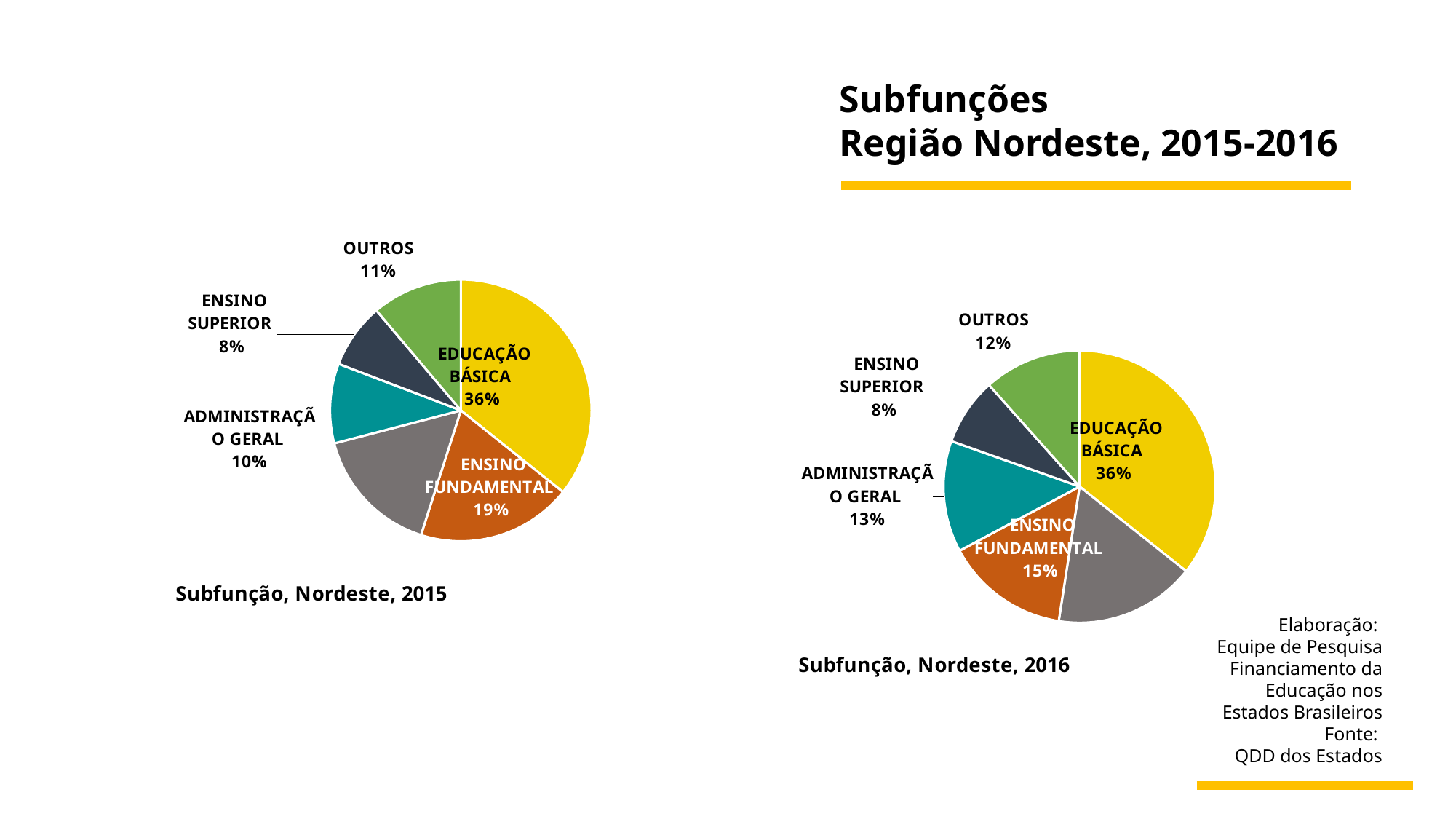
In the chart titled "Subfunção, Nordeste, 2016", what share does Administração Geral have? 13% In the chart titled "Subfunção, Nordeste, 2015", what share does Educação Básica have? 36% What type of chart is "Subfunção, Nordeste, 2015"? Pie chart In the chart titled "Subfunção, Nordeste, 2016", what share does Outros have? 12% In the chart titled "Subfunção, Nordeste, 2016", which labelled subfunction has the smallest slice? Ensino Superior In the chart titled "Subfunção, Nordeste, 2016", how many percentage points larger is Educação Básica than Ensino Fundamental? 21 percentage points In the chart titled "Subfunção, Nordeste, 2016", which is larger: Administração Geral or Outros? Administração Geral In the chart titled "Subfunção, Nordeste, 2015", how many percentage points larger is Educação Básica than Ensino Fundamental? 17 percentage points In the chart titled "Subfunção, Nordeste, 2015", which labelled subfunction has the largest slice? Educação Básica In the chart titled "Subfunção, Nordeste, 2015", what share does Ensino Fundamental have? 19% Is the share of Ensino Fundamental larger in the 2015 chart or in the 2016 chart? 2015 How many slices does the chart titled "Subfunção, Nordeste, 2016" have? 6